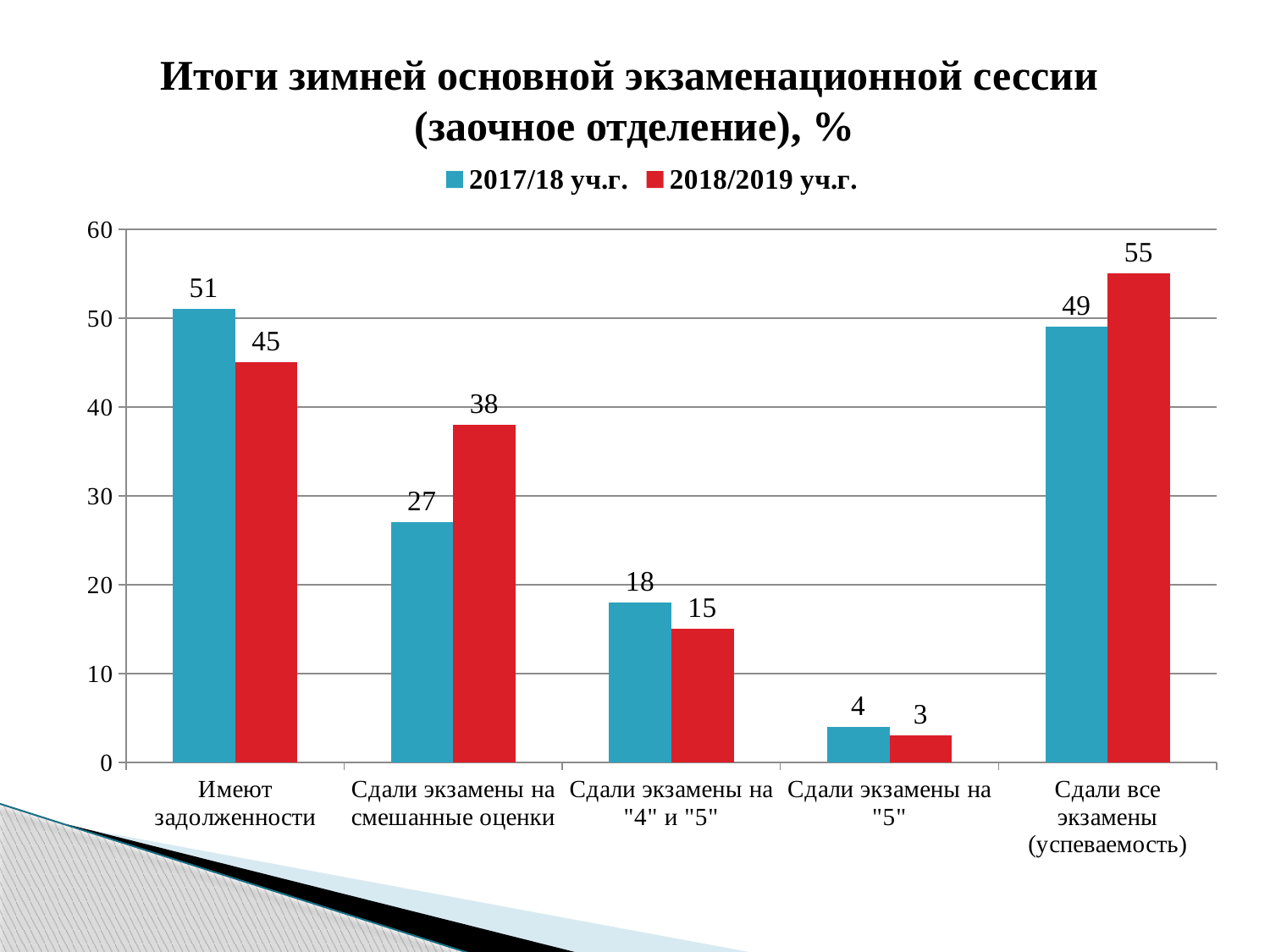
Which category has the highest value in the 2018/2019 уч.г. series? Сдали все экзамены (успеваемость) Which category has the lowest value in the 2017/18 уч.г. series? Сдали экзамены на "5" What is the value for "Имеют задолженности" in the 2017/18 уч.г. series? 51 How many categories are shown on the x axis? 5 How many series does the legend list? 2 What is the value for "Сдали экзамены на смешанные оценки" in the 2018/2019 уч.г. series? 38 What is the value for "Сдали экзамены на "5"" in the 2017/18 уч.г. series? 4 Is the 2018/2019 уч.г. value for "Имеют задолженности" greater or less than 50? less What colour are the bars for the 2018/2019 уч.г. series? red Which is larger for "Сдали все экзамены (успеваемость)": the 2017/18 уч.г. value or the 2018/2019 уч.г. value? 2018/2019 уч.г. What kind of chart is shown on the slide? bar chart What is the difference between the 2017/18 уч.г. and 2018/2019 уч.г. values for "Сдали экзамены на смешанные оценки"? 11